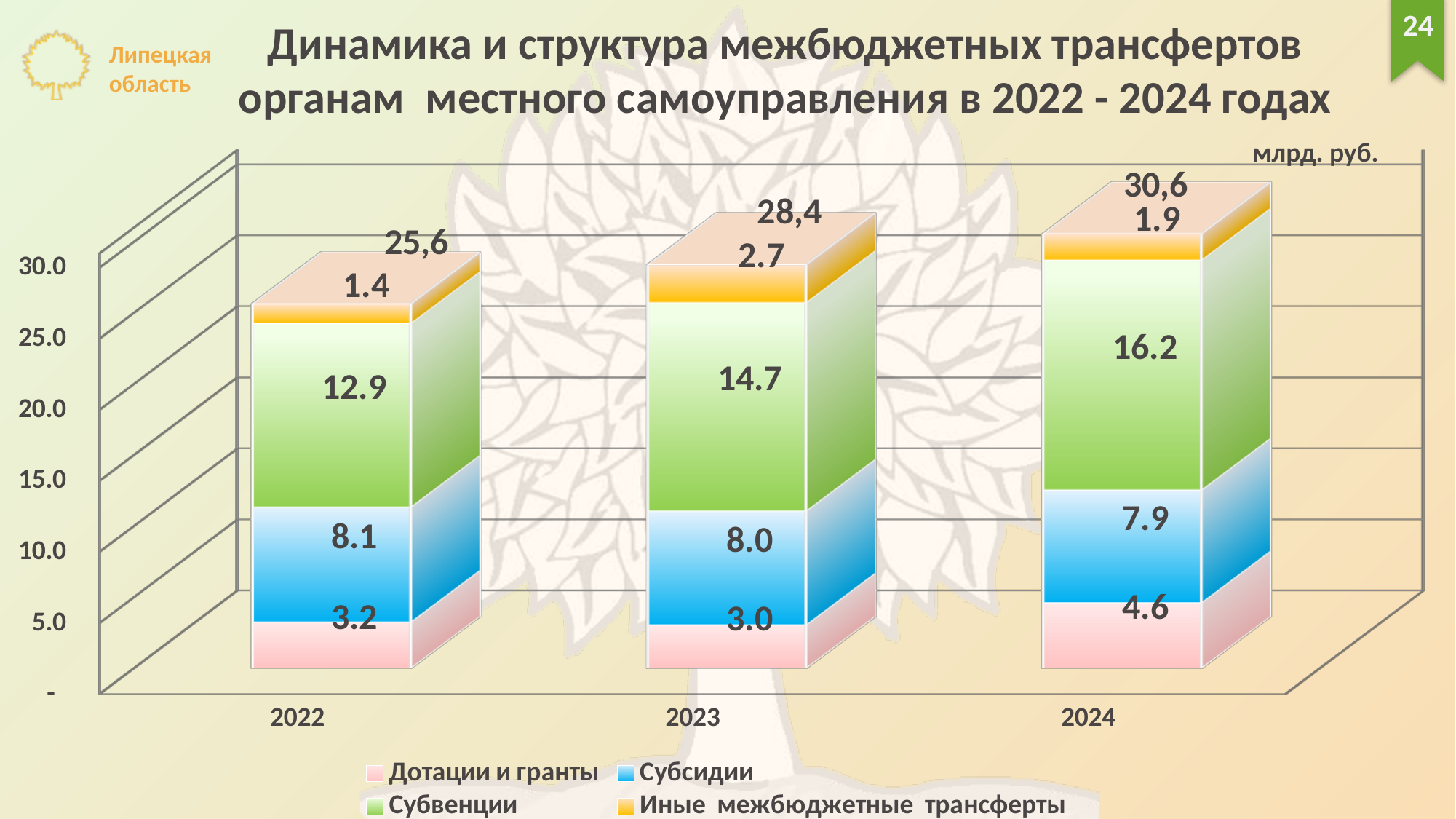
What is the value of Дотации и гранты for 2024? 4.6 What is the value of Иные межбюджетные трансферты for 2022? 1.4 What is the value of Субвенции for 2023? 14.7 Which year has the highest total of intergovernmental transfers? 2024 Which year has the lowest value for Субвенции? 2022 What is the total of the stacked bar for 2024? 30,6 Do the total values rise or fall from 2022 to 2024? Rise Which is larger: Иные межбюджетные трансферты in 2023 or in 2024? 2023 What is the difference between the Субвенции values for 2024 and 2022? 3.3 What kind of chart is shown on the slide? Stacked bar chart How many years are shown on the x axis? 3 How many series does the legend list? 4